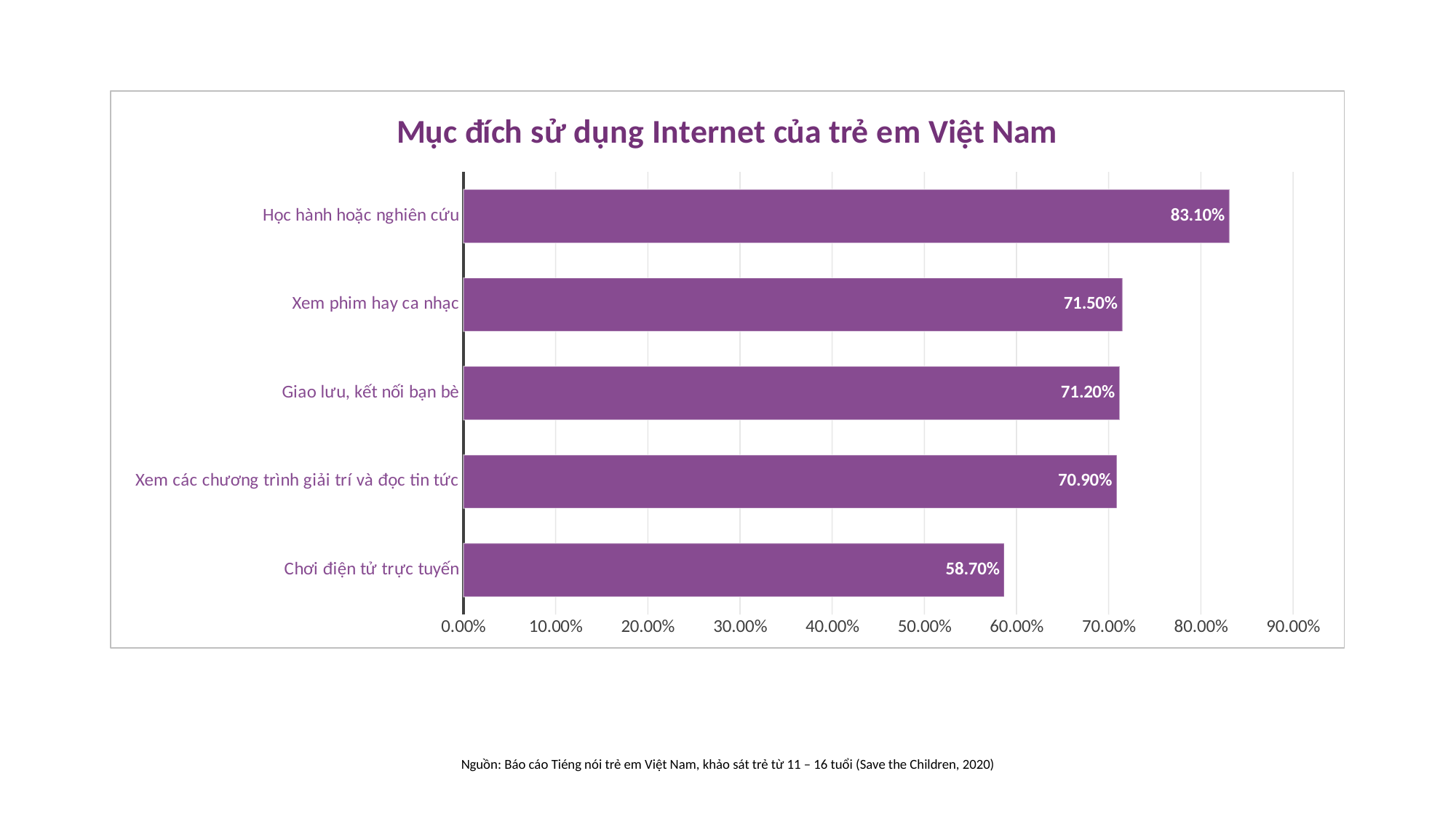
How many categories are shown in the chart? 5 What is the value for "Học hành hoặc nghiên cứu"? 83.10% What is the value for "Xem các chương trình giải trí và đọc tin tức"? 70.90% What is the difference between the values for "Xem phim hay ca nhạc" and "Giao lưu, kết nối bạn bè"? 0.30% Which category has the lowest value? Chơi điện tử trực tuyến What kind of chart is shown on the slide? Bar chart What is the value for "Xem phim hay ca nhạc"? 71.50% What is the title of the chart? Mục đích sử dụng Internet của trẻ em Việt Nam What is the value for "Chơi điện tử trực tuyến"? 58.70% What is the difference between the values for "Học hành hoặc nghiên cứu" and "Chơi điện tử trực tuyến"? 24.40% Which is larger: the value for "Học hành hoặc nghiên cứu" or the value for "Xem phim hay ca nhạc"? Học hành hoặc nghiên cứu Which category has the highest value? Học hành hoặc nghiên cứu